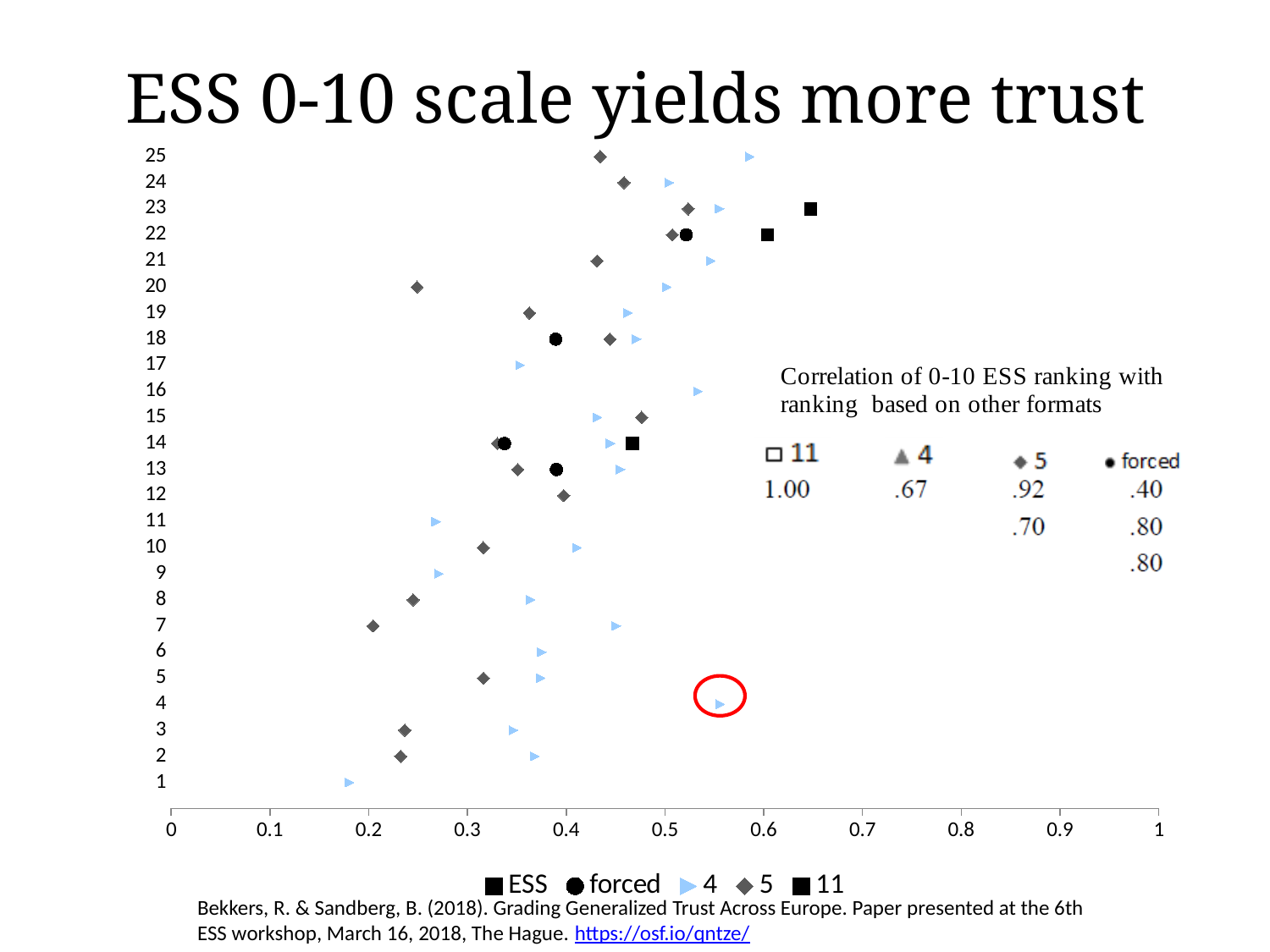
Is the value of the '5' series point at rank 20 greater or less than 0.3? less What kind of chart is shown on the slide? scatter chart Is the value of the '11' series point at rank 23 greater or less than 0.6? greater How many ranking positions are shown on the vertical axis of the chart? 25 Is the value of the '4' series point at rank 1 greater or less than 0.2? less What is the title of the slide containing the chart? ESS 0-10 scale yields more trust At rank 20, which series has the larger value: '4' or '5'? 4 How many series does the chart legend list? 5 At rank 22, which series has the larger value: '11' or 'forced'? 11 What is the maximum value shown on the horizontal axis of the chart? 1